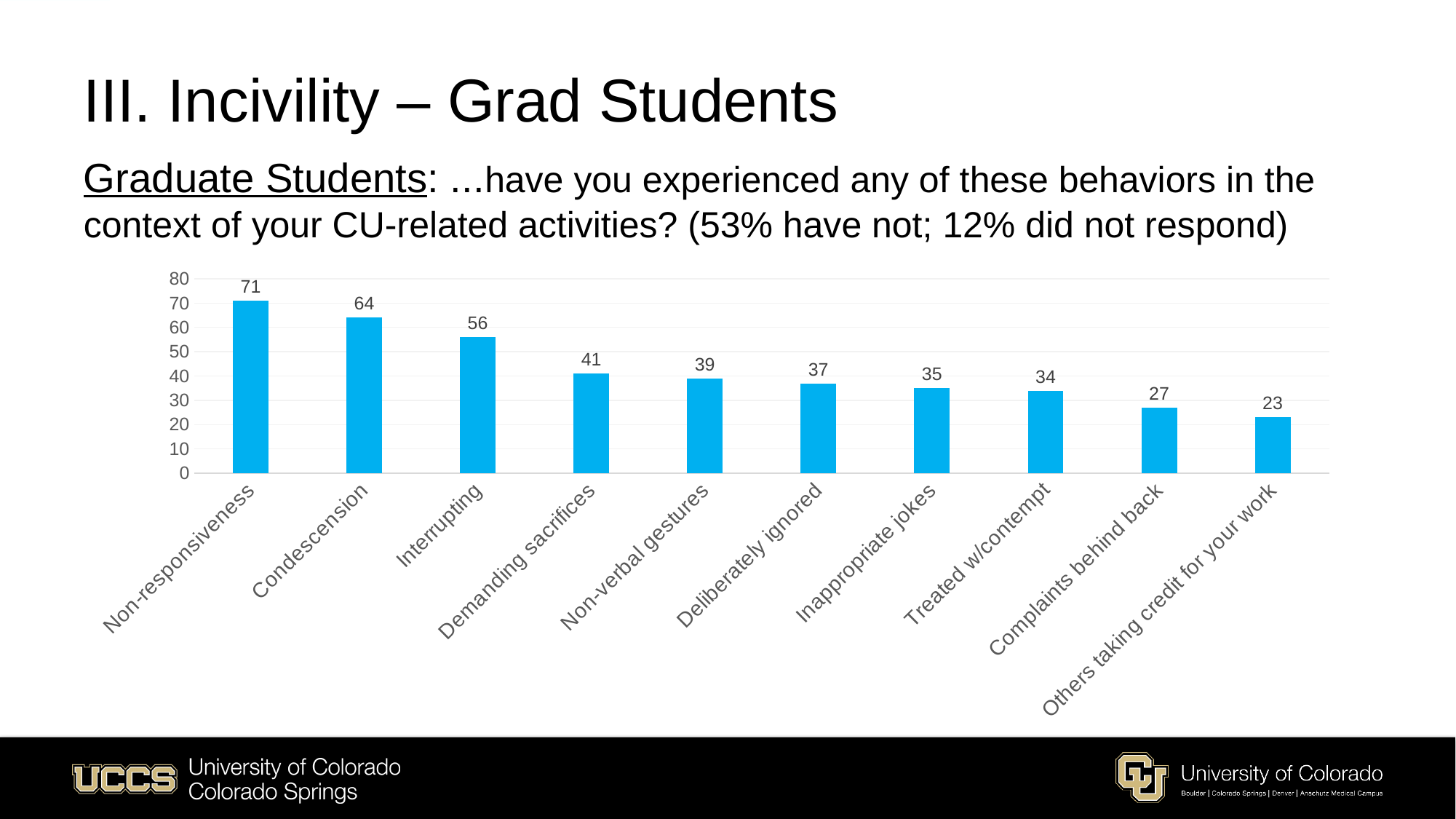
What is the value for Demanding sacrifices? 41 What is the difference between the values for Condescension and Interrupting? 8 What is the value for Deliberately ignored? 37 How many categories are shown in the chart? 10 What is the value for Non-responsiveness? 71 What kind of chart is shown on the slide? bar chart Is the value for Non-verbal gestures greater or less than 30? greater Which category has the lowest value? Others taking credit for your work What is the value for Complaints behind back? 27 Which is larger, the value for Inappropriate jokes or the value for Treated w/contempt? Inappropriate jokes Which category has the highest value? Non-responsiveness Do the values rise or fall from left to right along the x axis? fall